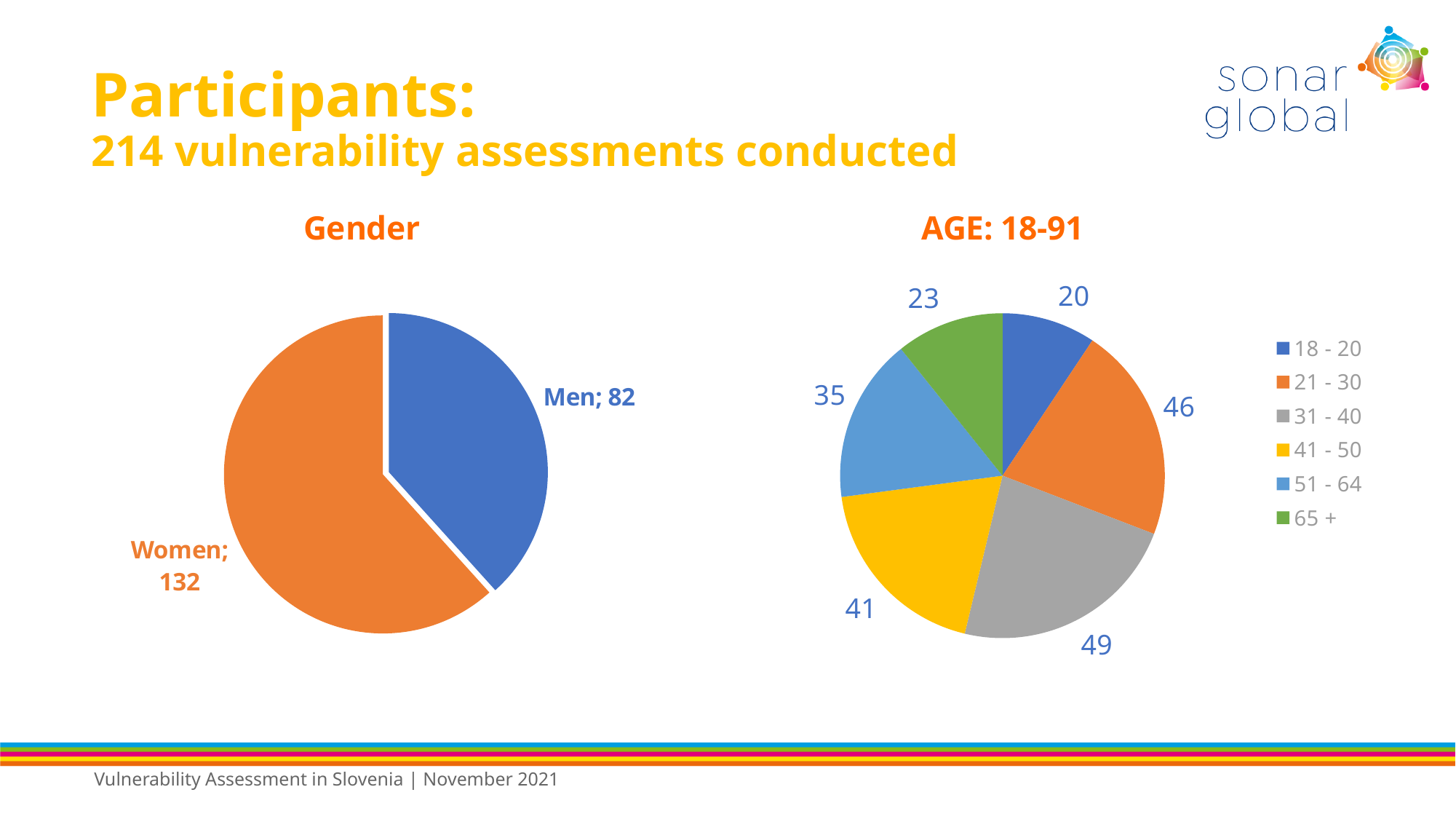
In the AGE: 18-91 chart, how many participants are in the 31 - 40 age group? 49 In the AGE: 18-91 chart, how many participants are in the 65 + age group? 23 In the AGE: 18-91 chart, which age group has the fewest participants? 18 - 20 In the Gender chart, how many participants are women? 132 In the AGE: 18-91 chart, what is the difference between the 21 - 30 and 51 - 64 age groups? 11 In the AGE: 18-91 chart, which colour represents the 41 - 50 age group? Yellow In the Gender chart, what is the difference between the number of women and the number of men? 50 In the AGE: 18-91 chart, how many age groups does the legend list? 6 What kind of chart is the Gender chart? Pie chart In the AGE: 18-91 chart, which age group has the most participants? 31 - 40 In the Gender chart, how many participants are men? 82 In the Gender chart, which group is larger, men or women? Women